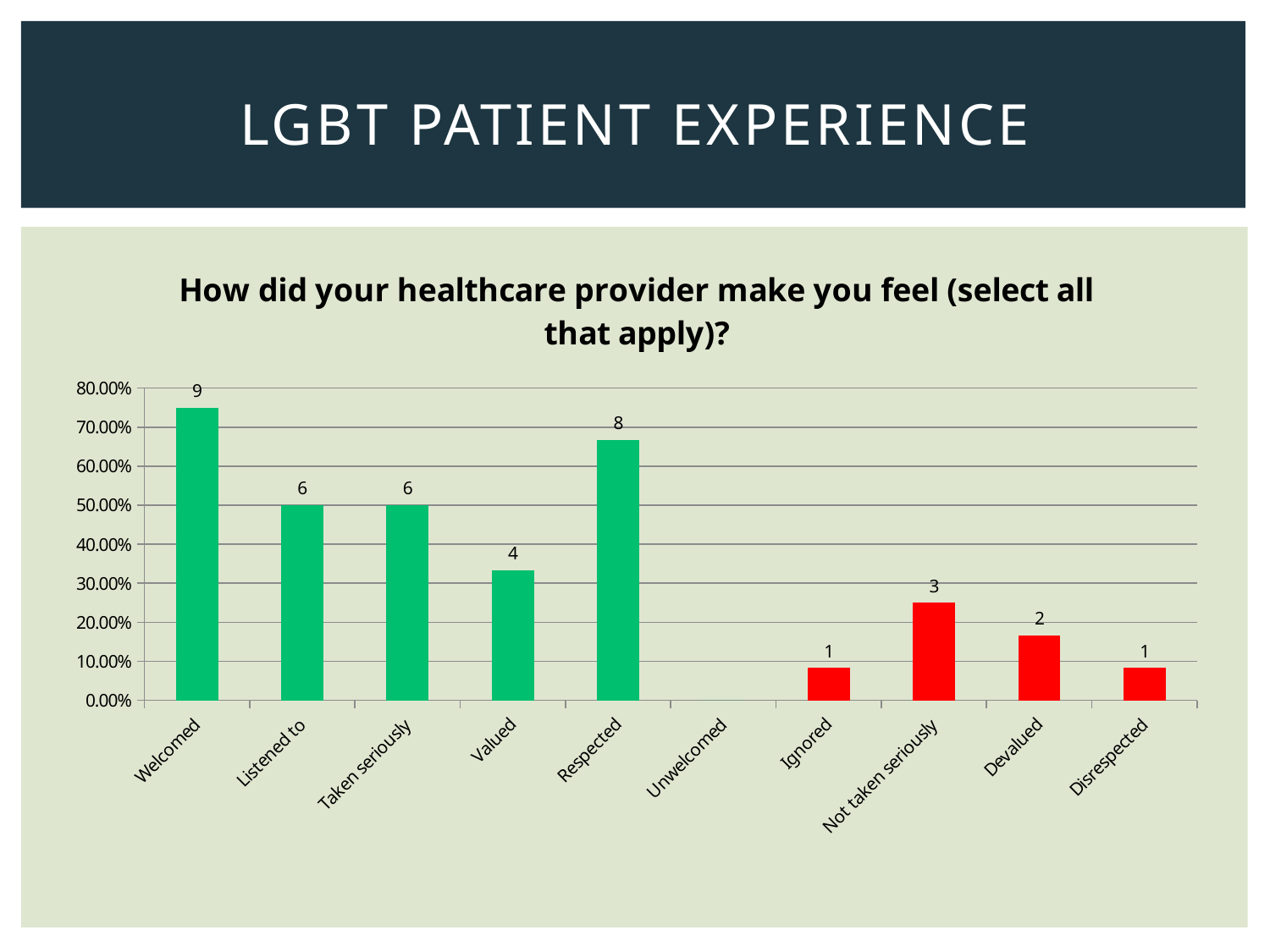
What data label is shown above the bar for Welcomed? 9 How many categories are shown on the x axis of the chart? 10 What data label is shown above the bar for Respected? 8 Which bar is taller, Listened to or Valued? Listened to What type of chart is shown on the slide? bar chart Is the value for Welcomed greater or less than 70.00%? greater What data label is shown above the bar for Not taken seriously? 3 What is the title of the chart? How did your healthcare provider make you feel (select all that apply)? Which category has no bar shown at all? Unwelcomed What is the difference between the data labels for Welcomed and Respected? 1 What data label is shown above the bar for Valued? 4 Which category has the tallest bar? Welcomed